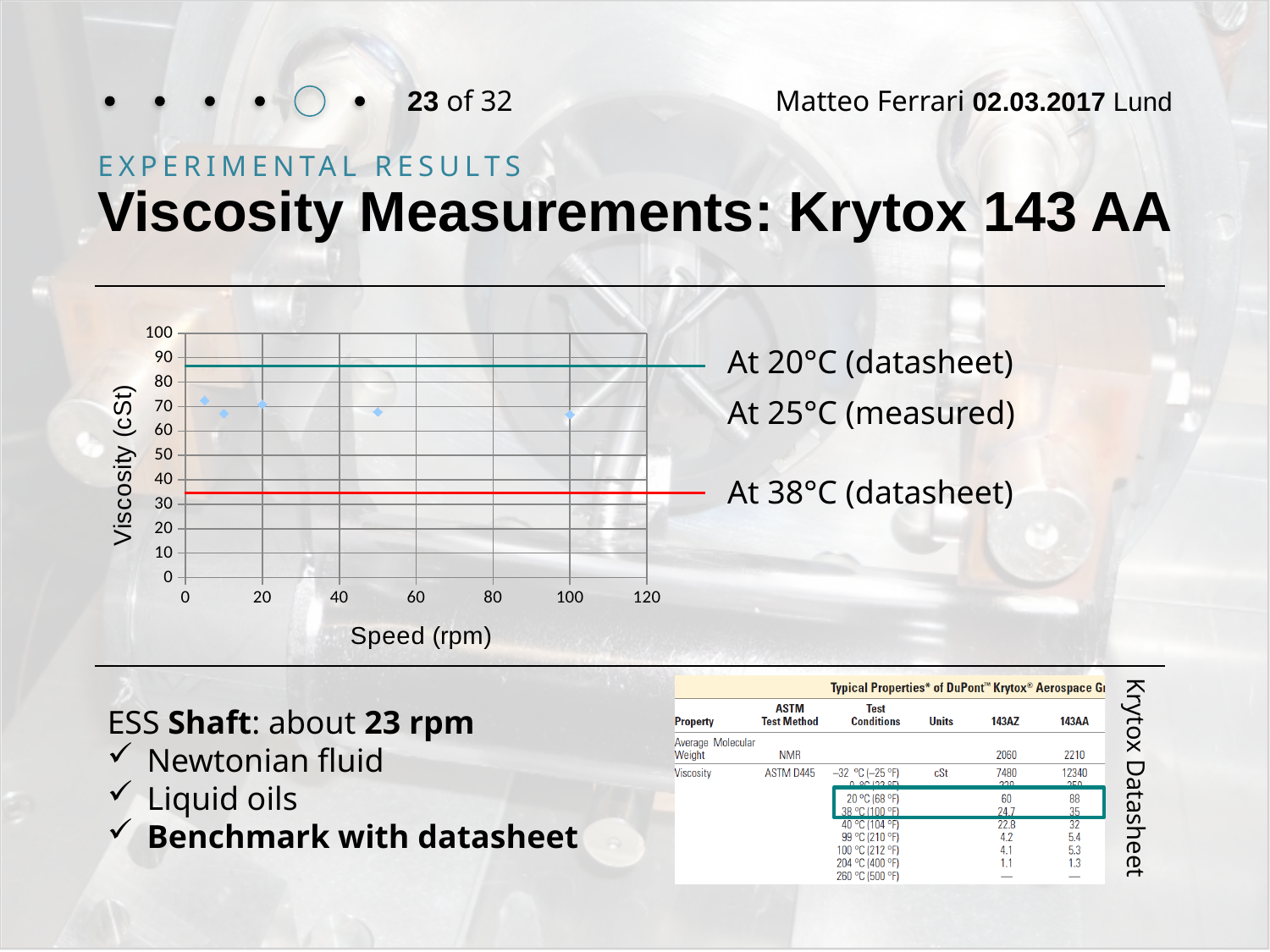
Is the measured viscosity at 100 rpm greater or less than 80 cSt? less Is the 'At 38°C (datasheet)' line greater or less than 40 cSt? less What kind of chart is shown on the slide? scatter chart Is the 'At 20°C (datasheet)' line greater or less than 80 cSt? greater How many measured data points (At 25°C) are plotted on the chart? 5 Are the measured viscosity values at 25°C higher or lower than the 20°C datasheet line? lower Are the measured viscosity values at 25°C higher or lower than the 38°C datasheet line? higher What is the label of the horizontal axis of the chart? Speed (rpm) Which datasheet line shows the higher viscosity, At 20°C or At 38°C? At 20°C (datasheet) How many series are labelled next to the chart? 3 What is the label of the vertical axis of the chart? Viscosity (cSt)